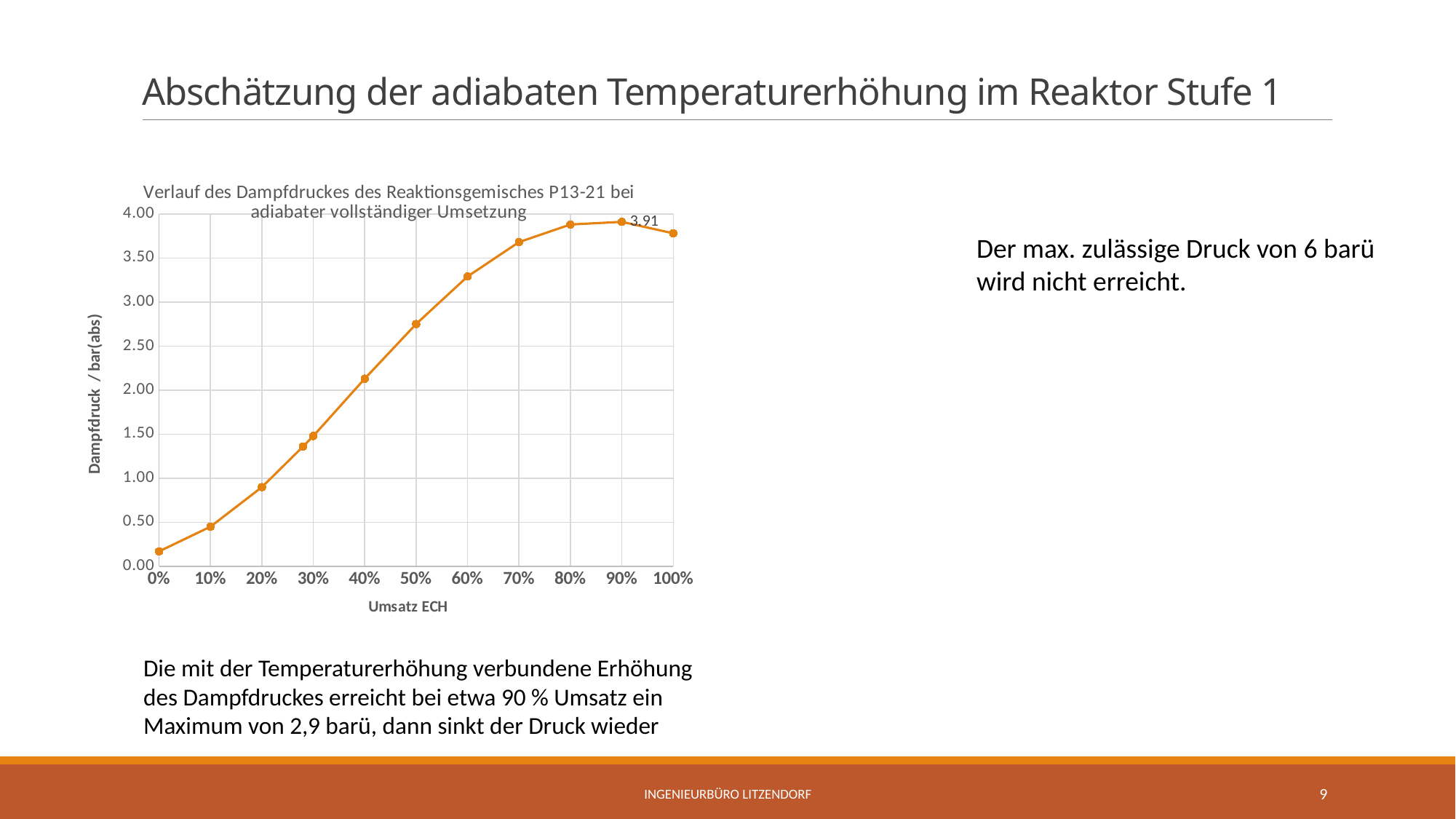
What is the label of the y axis of the chart? Dampfdruck / bar(abs) What kind of chart is shown on the slide? line chart At which Umsatz ECH value does the Dampfdruck reach its highest point? 90% Does the Dampfdruck rise or fall between 0% and 90% Umsatz ECH? rise Is the Dampfdruck at 100% Umsatz ECH greater or less than 3.50? greater Is the Dampfdruck at 50% Umsatz ECH greater or less than 2.50? greater Is the Dampfdruck at 20% Umsatz ECH greater or less than 1.00? less What is the labelled value of the data point at 90% Umsatz ECH? 3.91 Which has the higher Dampfdruck: 60% or 80% Umsatz ECH? 80% At which Umsatz ECH value is the Dampfdruck lowest? 0% What is the label of the x axis of the chart? Umsatz ECH